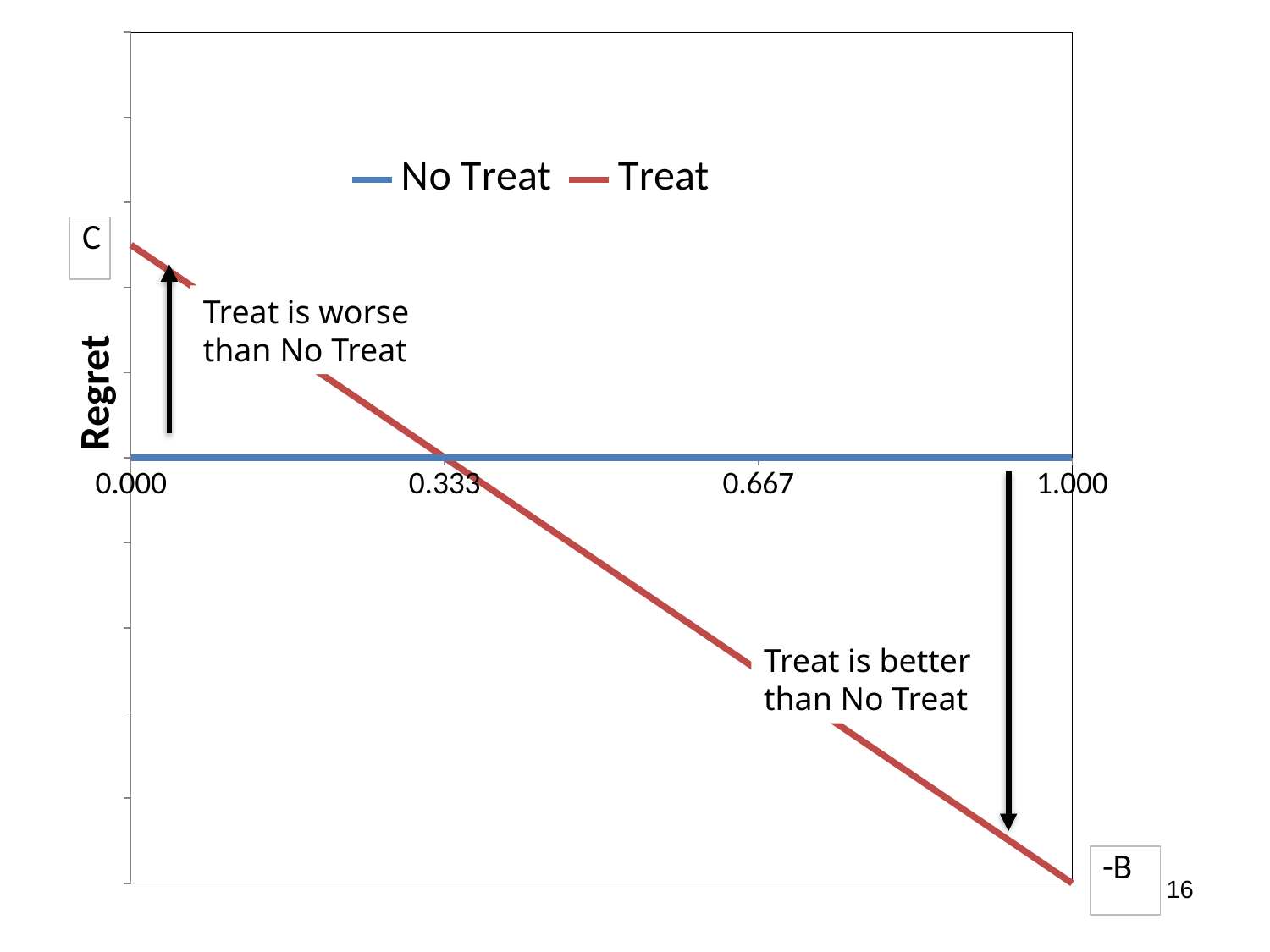
At which labelled x-axis tick do the Treat and No Treat lines cross? 0.333 Does the No Treat line rise, fall, or stay flat across the x axis? stay flat What kind of chart is shown on the slide? line chart What label marks the value of the Treat line at x = 0.000? C At x = 1.000, which series has the higher Regret value, Treat or No Treat? No Treat At x = 0.000, which series has the higher Regret value, Treat or No Treat? Treat What label marks the value of the Treat line at x = 1.000? -B Which series are listed in the legend? No Treat and Treat Does the Treat line rise or fall as the x-axis value increases from 0.000 to 1.000? fall What is the title of the vertical axis? Regret How many series does the legend list? 2 How many tick labels are shown on the x axis? 4